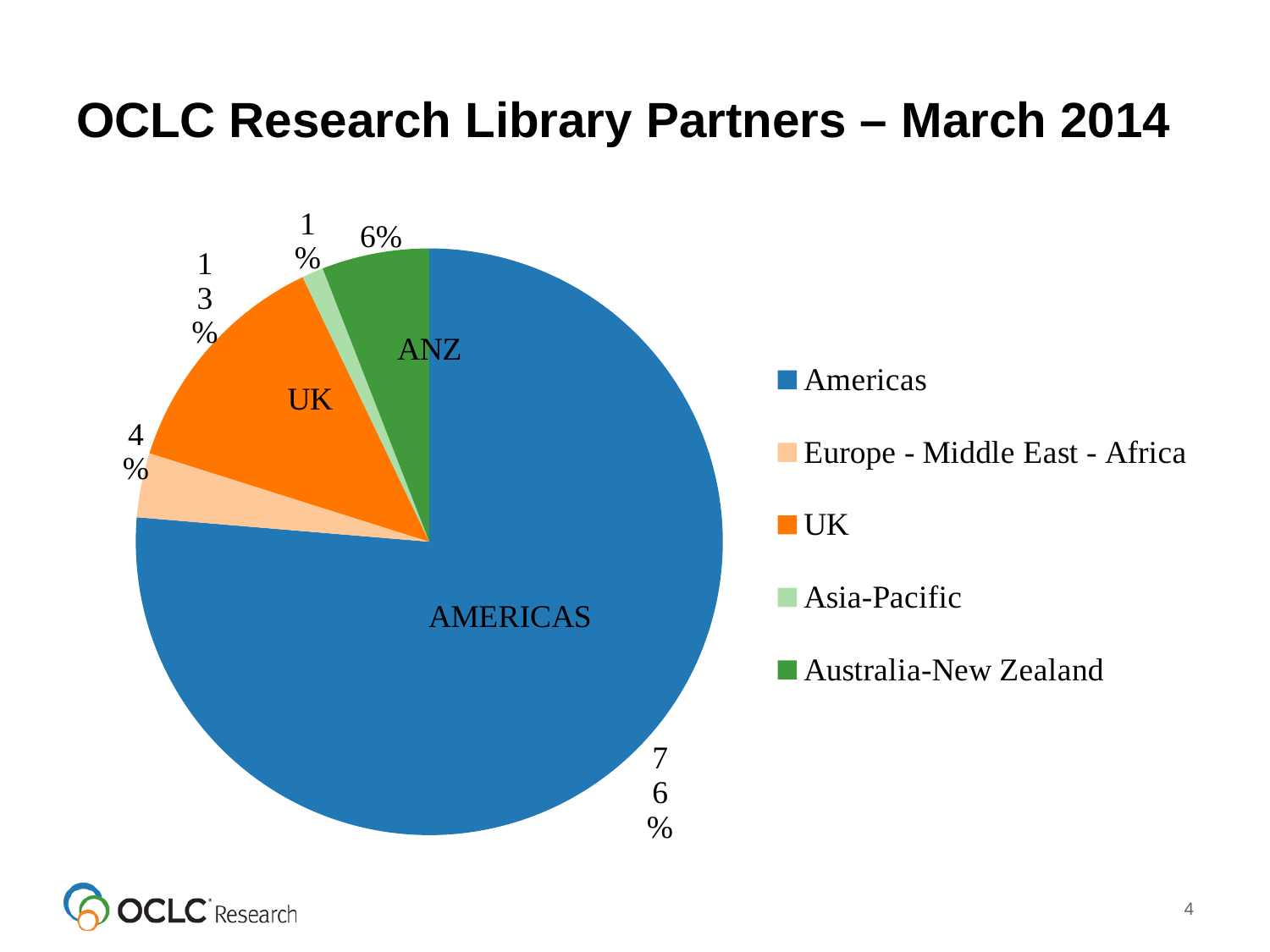
Which region has the largest slice of the pie? Americas What share of the pie does Asia-Pacific hold? 1% How many regions are shown in the pie chart? 5 What share of the pie does UK hold? 13% What is the title of the slide containing the chart? OCLC Research Library Partners – March 2014 What share of the pie does Americas hold? 76% Which slice is larger, UK or Australia-New Zealand? UK What share of the pie does Australia-New Zealand hold? 6% What kind of chart is shown on the slide? pie chart What share of the pie does Europe - Middle East - Africa hold? 4% What is the difference in percentage points between the Americas slice and the UK slice? 63 Which region has the smallest slice of the pie? Asia-Pacific